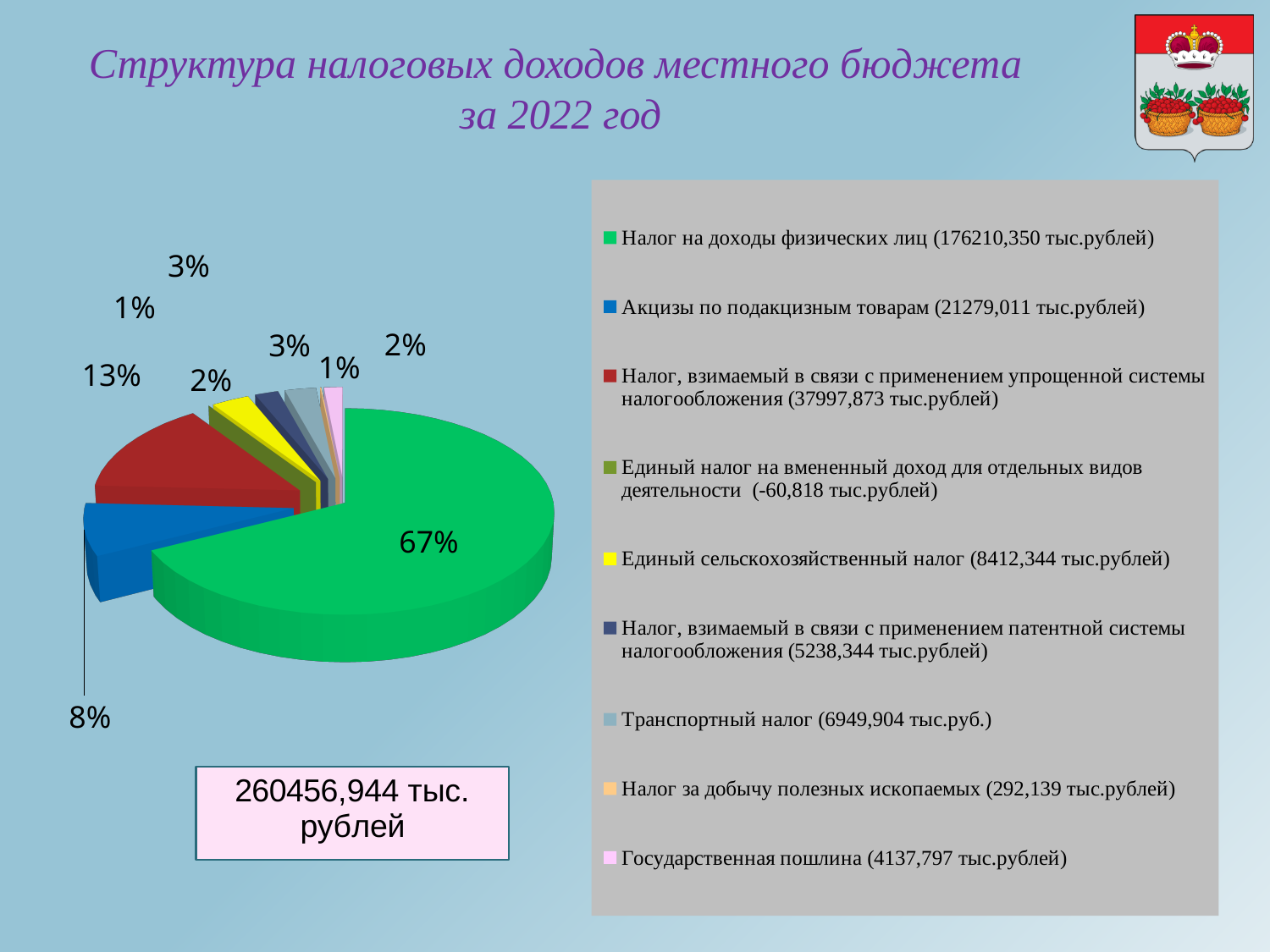
What share of the pie is labelled for the red slice (Налог, взимаемый в связи с применением упрощенной системы налогообложения)? 13% According to the legend, what is the amount for Налог на доходы физических лиц? 176210,350 тыс.рублей How many entries does the legend list? 9 According to the legend, what is the amount for Транспортный налог? 6949,904 тыс.руб. What is the title of the slide containing the chart? Структура налоговых доходов местного бюджета за 2022 год What share of the pie is labelled for the blue slice (Акцизы по подакцизным товарам)? 8% What kind of chart is shown on the slide? pie chart Which is larger: the share for Налог на доходы физических лиц or the share for Акцизы по подакцизным товарам? Налог на доходы физических лиц What share of the pie does the largest slice (Налог на доходы физических лиц) have? 67% What total amount is shown in the box below the pie chart? 260456,944 тыс. рублей According to the legend, what is the amount for Акцизы по подакцизным товарам? 21279,011 тыс.рублей Which category has the largest share of the pie? Налог на доходы физических лиц